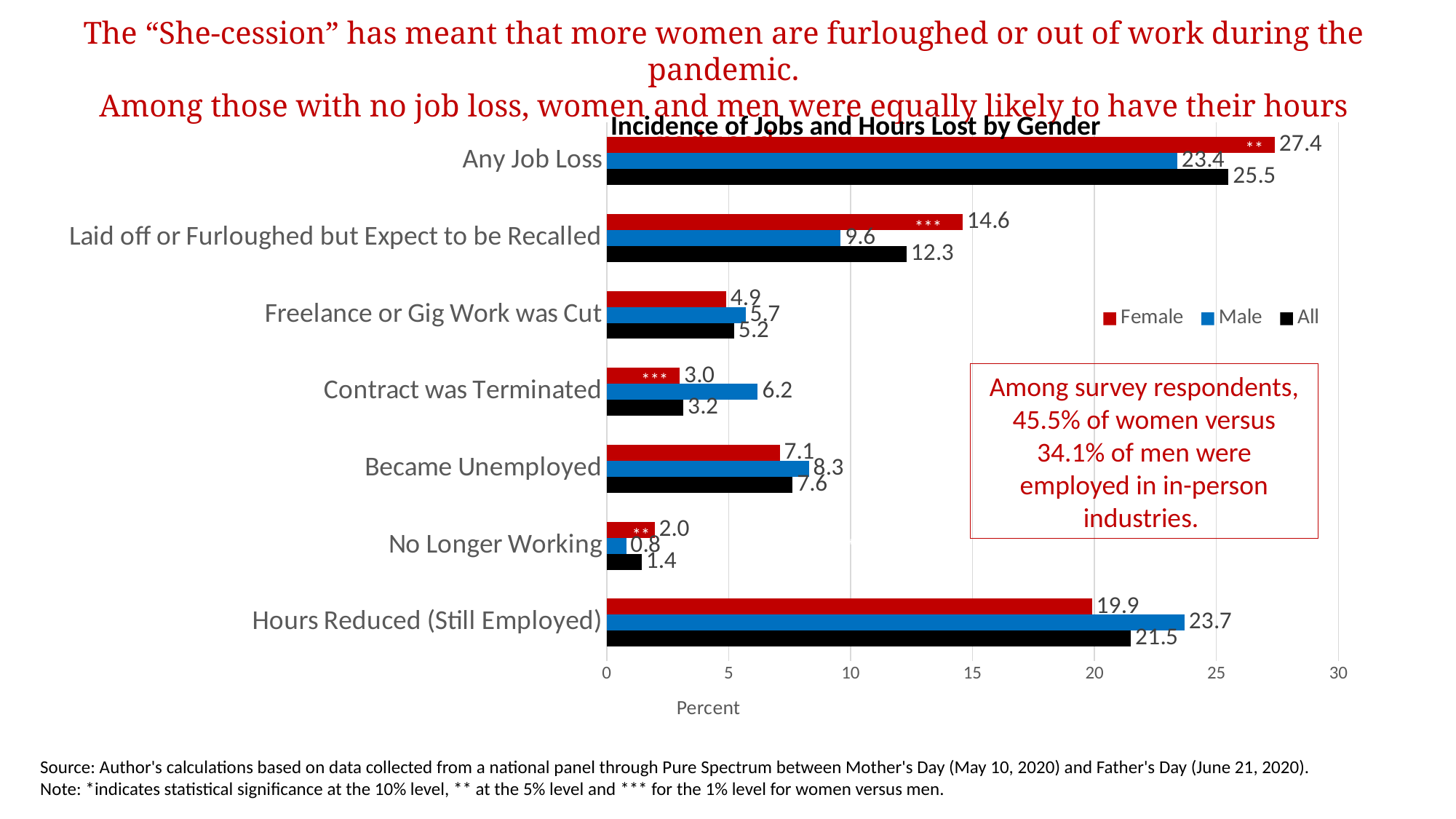
What is the difference between the Female and Male values for Laid off or Furloughed but Expect to be Recalled? 5.0 What is the Female value for Any Job Loss? 27.4 What is the Male value for Hours Reduced (Still Employed)? 23.7 How many series does the legend list? 3 Which category has the highest Female value? Any Job Loss How many categories are shown on the chart? 7 What is the title of the chart? Incidence of Jobs and Hours Lost by Gender For Contract was Terminated, which is larger, the Female value or the Male value? Male What is the All value for Laid off or Furloughed but Expect to be Recalled? 12.3 Is the Female value for Hours Reduced (Still Employed) greater or less than 20? less What kind of chart is shown on the slide? bar chart Which category has the lowest Male value? No Longer Working